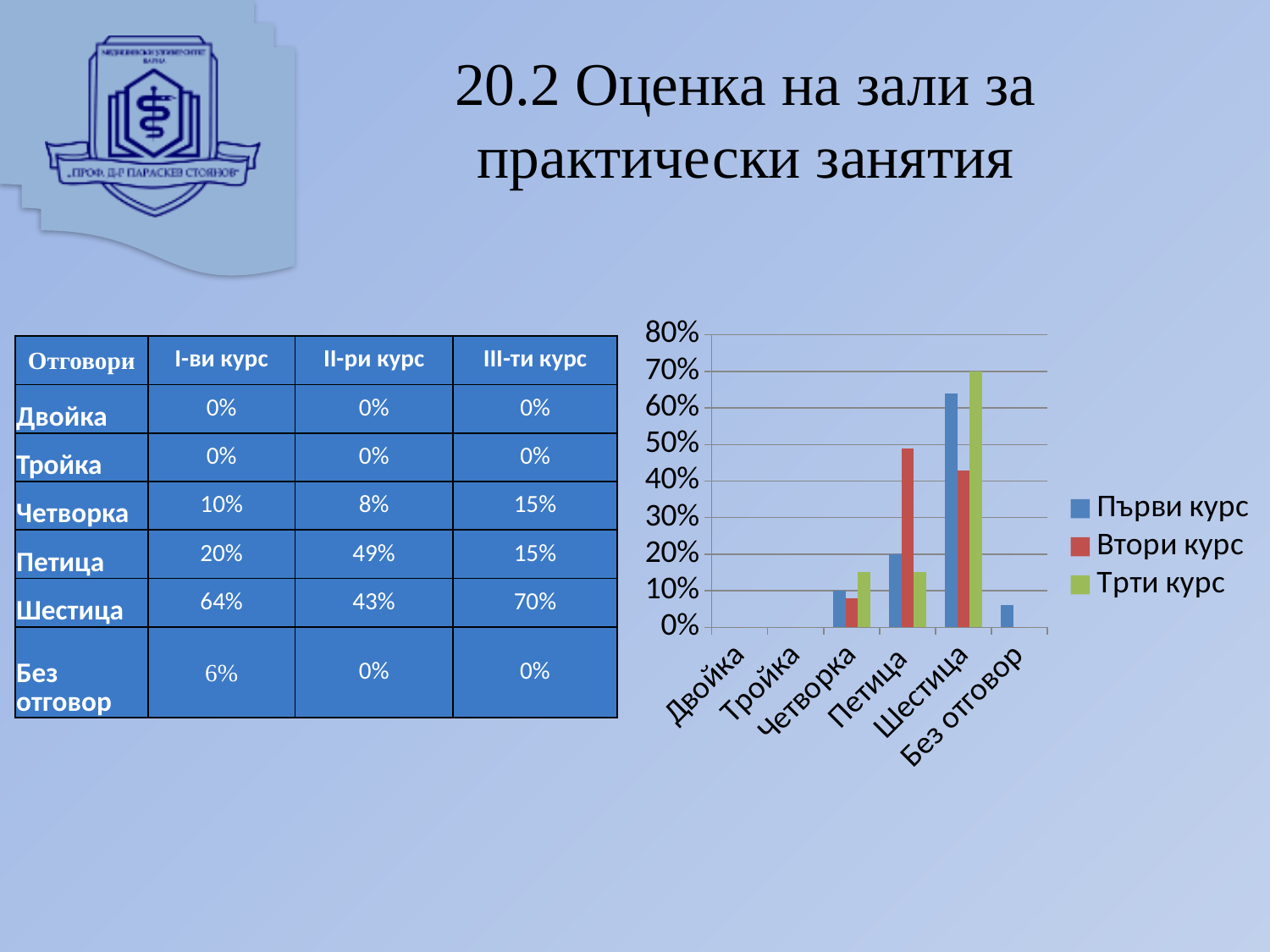
What is the difference between Трети курс and Втори курс in the Шестица category? 27% Is the value for Първи курс in the Шестица category greater or less than 60%? greater What kind of chart is shown on the slide? bar chart Which series has the highest value in the Петица category? Втори курс What is the value for Трети курс in the Шестица category? 70% What is the value for Втори курс in the Петица category? 49% In the Шестица category, which is larger: Първи курс or Втори курс? Първи курс Is the value for Втори курс in the Шестица category greater or less than 50%? less How many series does the chart legend list? 3 Which category has the highest value for Първи курс? Шестица How many categories are shown on the x axis of the chart? 6 What is the value for Първи курс in the Четворка category? 10%